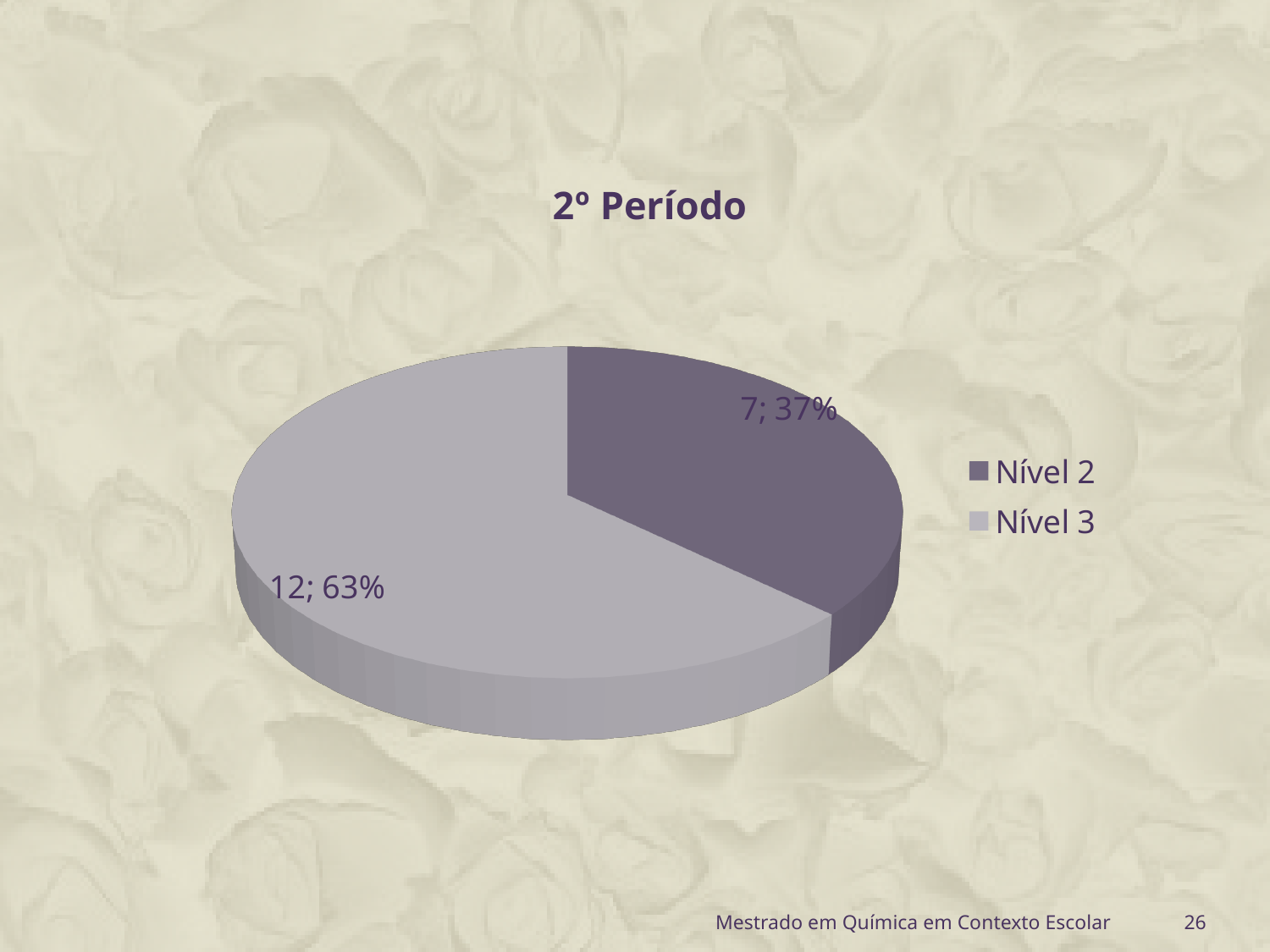
Which category has the smallest slice? Nível 2 What is the count for Nível 3? 12 Which is larger, the count for Nível 2 or Nível 3? Nível 3 What share of the pie does Nível 3 represent? 63% How many slices does the pie chart have? 2 What is the title of the pie chart? 2º Período What share of the pie does Nível 2 represent? 37% Which category has the largest slice? Nível 3 How many entries does the legend list? 2 What type of chart is shown on the slide? pie chart What is the difference between the counts for Nível 3 and Nível 2? 5 What is the count for Nível 2? 7